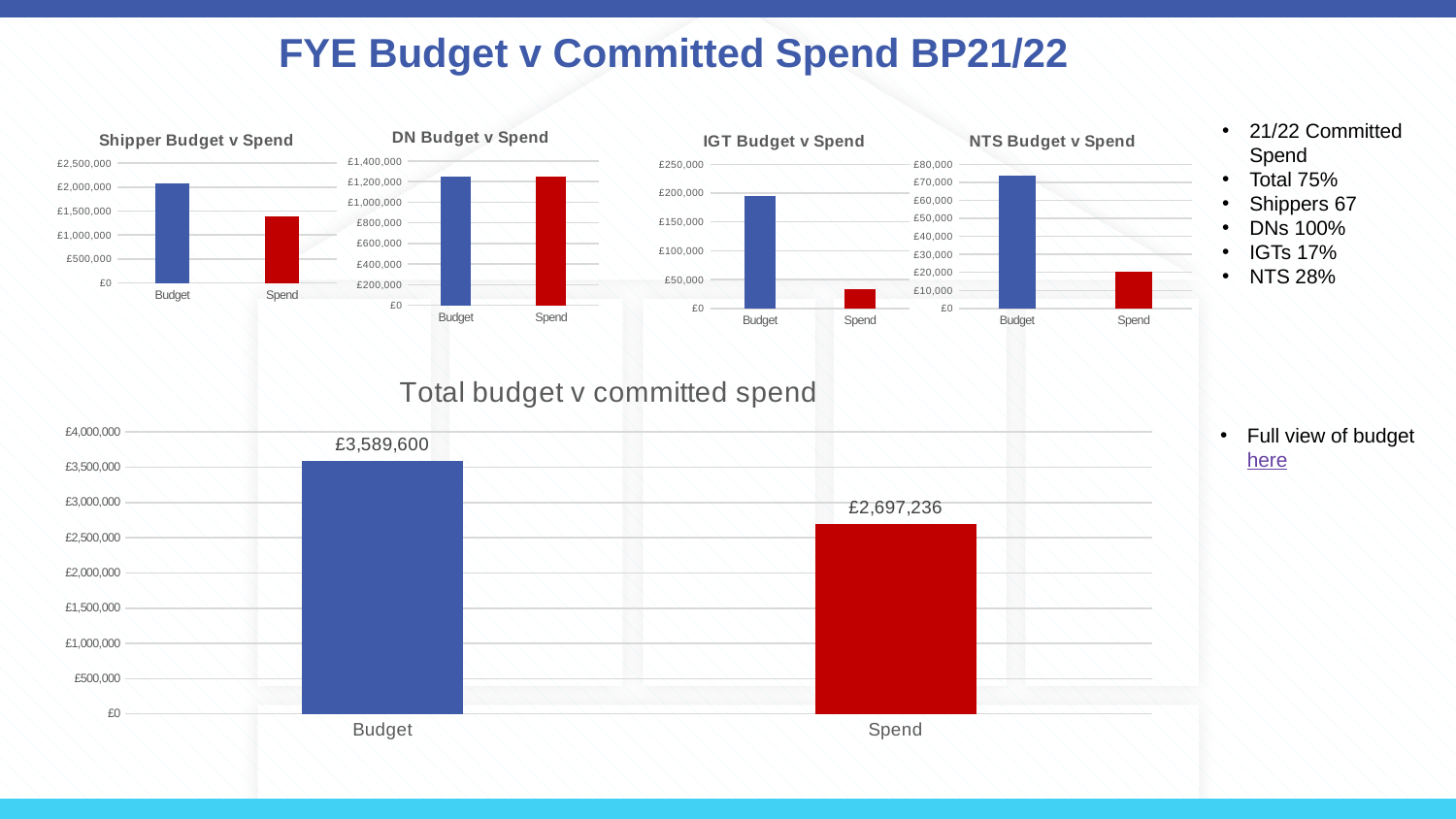
How many bars are plotted on the Total budget v committed spend chart? 2 On the IGT Budget v Spend chart, is the value for Spend greater or less than £50,000? less On the NTS Budget v Spend chart, is the value for Budget greater or less than £60,000? greater On the Shipper Budget v Spend chart, is the value for Spend greater or less than £1,500,000? less On the Total budget v committed spend chart, which bar is higher, Budget or Spend? Budget On the Total budget v committed spend chart, what is the difference between Budget and Spend? £892,364 On the IGT Budget v Spend chart, which is larger, Budget or Spend? Budget What kind of chart is the Shipper Budget v Spend chart? Bar chart On the NTS Budget v Spend chart, which bar is the lowest? Spend On the Total budget v committed spend chart, what is the value for Budget? £3,589,600 On the Total budget v committed spend chart, what is the value for Spend? £2,697,236